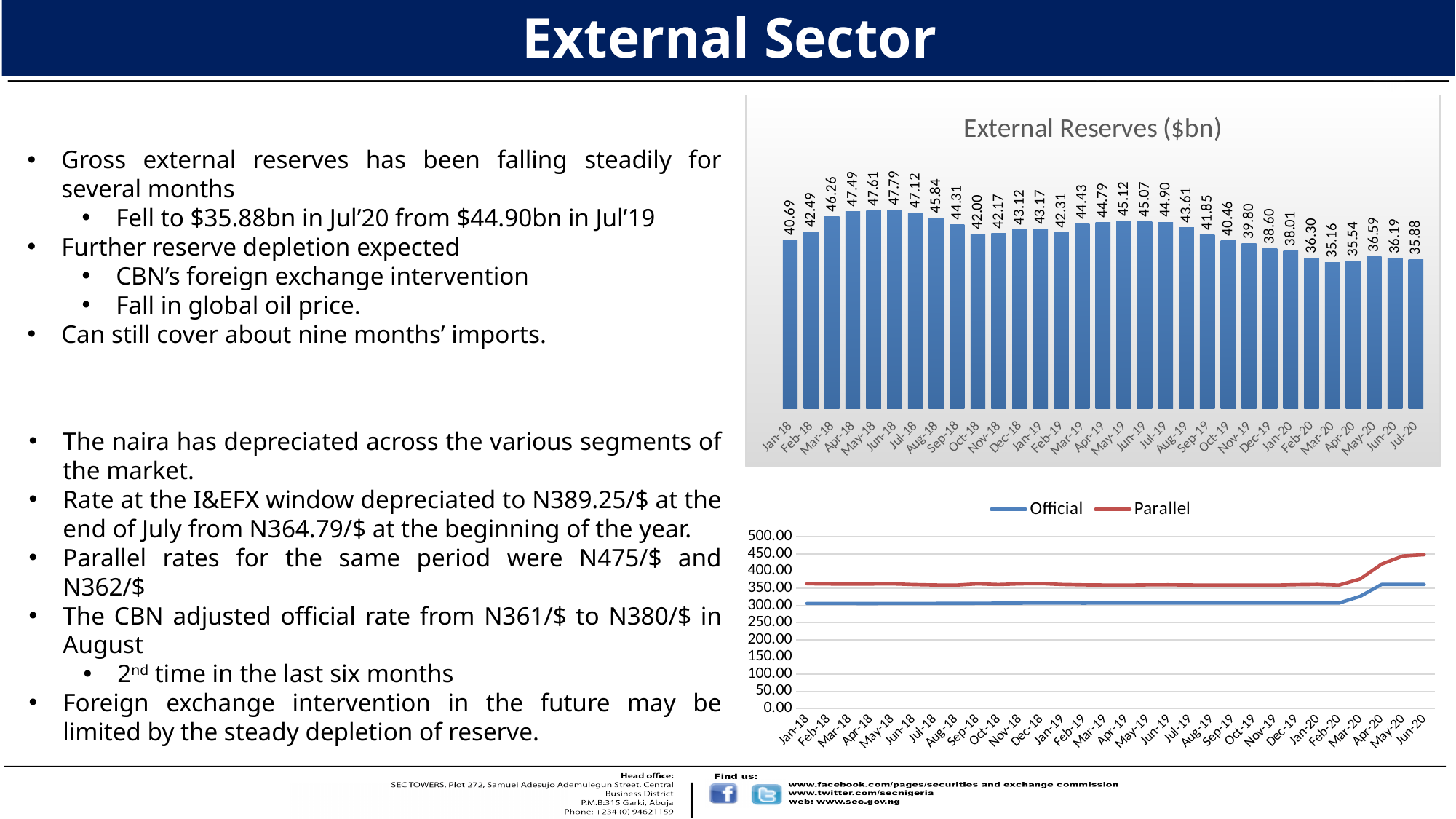
How many bars are plotted in the External Reserves ($bn) chart? 31 In the External Reserves ($bn) chart, what is the difference between the Jul-19 and Jul-20 values? 9.02 In the External Reserves ($bn) chart, which month has the lowest value? Mar-20 In the External Reserves ($bn) chart, which month has the highest value? Jun-18 In the External Reserves ($bn) chart, which is larger, the value for Jan-18 or the value for Jan-20? Jan-18 What kind of chart is the External Reserves ($bn) chart? bar chart In the bottom line chart, which series is higher in Jun-20, Official or Parallel? Parallel In the External Reserves ($bn) chart, what is the value for Jul-20? 35.88 How many series does the legend of the bottom line chart list? 2 In the bottom line chart, is the Parallel value for Jun-20 greater or less than 400.00? greater In the External Reserves ($bn) chart, do the values generally rise or fall from Jul-19 to Jul-20? fall In the External Reserves ($bn) chart, what is the value for Jul-19? 44.90